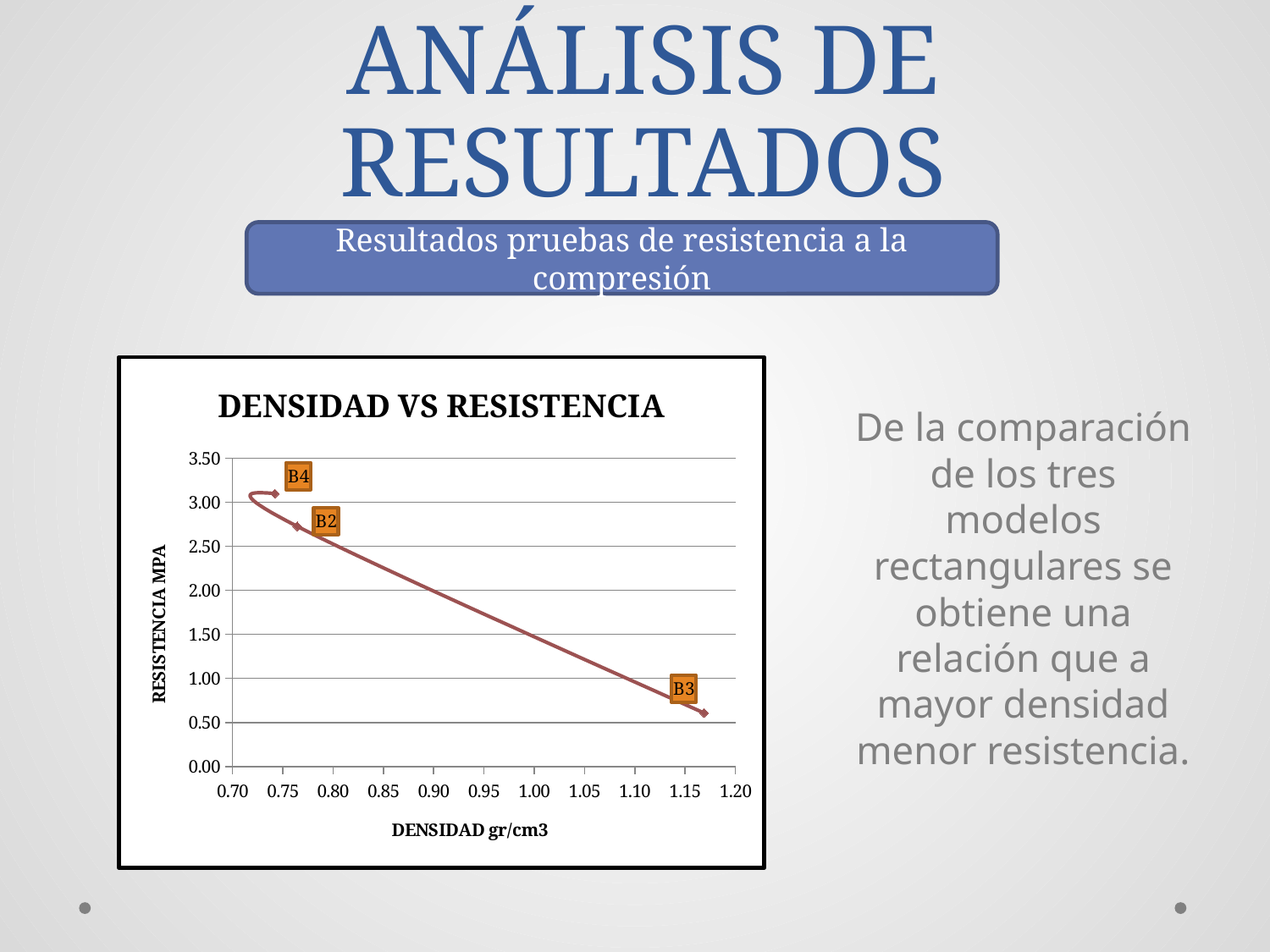
How many data points are labelled on the chart? 3 Is the resistencia value for B3 greater or less than 1.00? less As densidad increases along the x axis, does resistencia rise or fall? fall Is the resistencia value for B4 greater or less than 3.00? greater What is the title of the chart? DENSIDAD VS RESISTENCIA What is the label of the vertical axis of the chart? RESISTENCIA MPA Which labelled point has the highest densidad value? B3 Is the densidad value for B3 greater or less than 1.10? greater Which labelled point has the lowest resistencia value? B3 Which labelled point has the highest resistencia value? B4 Which has a higher resistencia value, B4 or B2? B4 What kind of chart is shown on the slide? scatter chart